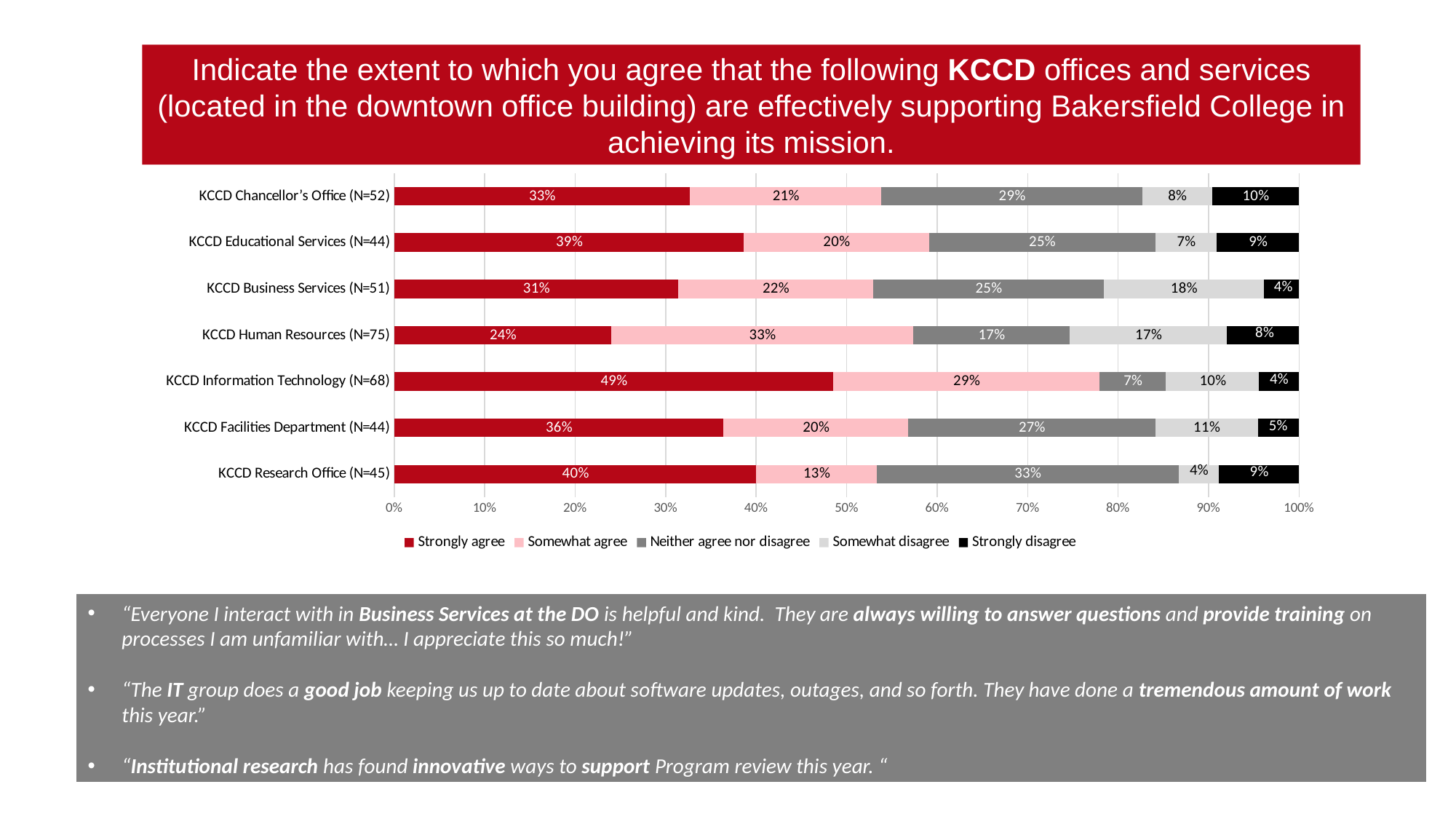
What is the sample size (N) shown for KCCD Human Resources? 75 What is the Somewhat agree value for KCCD Human Resources? 33% How many response categories does the legend list? 5 What is the Neither agree nor disagree value for KCCD Research Office? 33% Which office has the highest Strongly agree percentage? KCCD Information Technology (N=68) What is the difference between the Strongly agree values for KCCD Information Technology and KCCD Human Resources? 25% What is the Somewhat disagree value for KCCD Business Services? 18% What percentage of respondents strongly agree that KCCD Information Technology is effectively supporting Bakersfield College? 49% Which office has the lowest Strongly agree percentage? KCCD Human Resources (N=75) What type of chart is shown on the slide? Stacked bar chart Which has a larger Strongly disagree value, KCCD Chancellor's Office or KCCD Business Services? KCCD Chancellor's Office How many KCCD offices or services are shown in the chart? 7